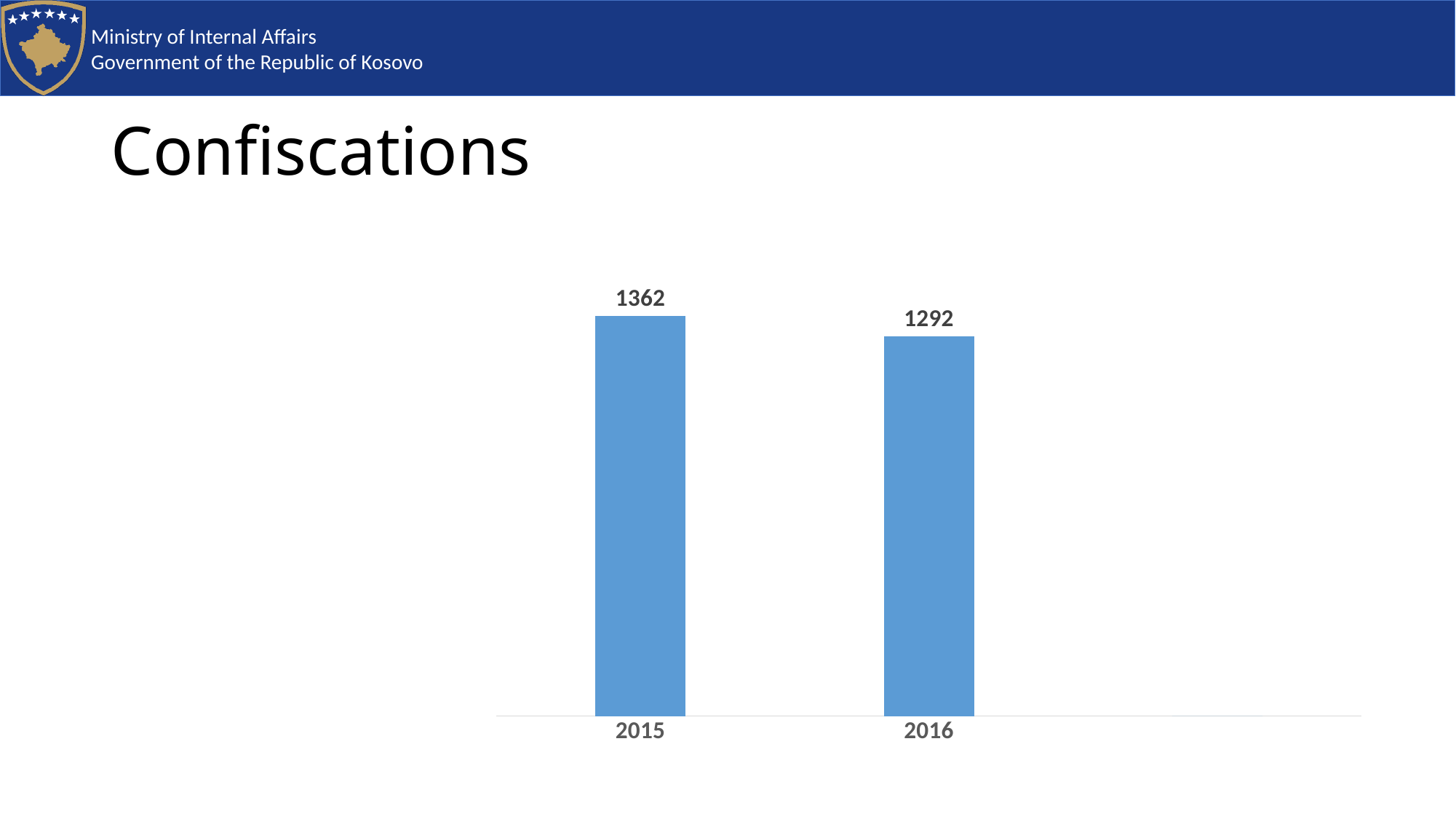
What is the title of the slide containing the chart? Confiscations What is the difference between the values for 2015 and 2016? 70 Do the values rise or fall from 2015 to 2016? fall What is the value for 2016? 1292 Which is larger, the value for 2015 or the value for 2016? 2015 What is the value for 2015? 1362 How many bars are shown in the chart? 2 Which year has the lowest value? 2016 What kind of chart is shown on the slide? bar chart What colour are the bars in the chart? blue Which year has the highest value? 2015